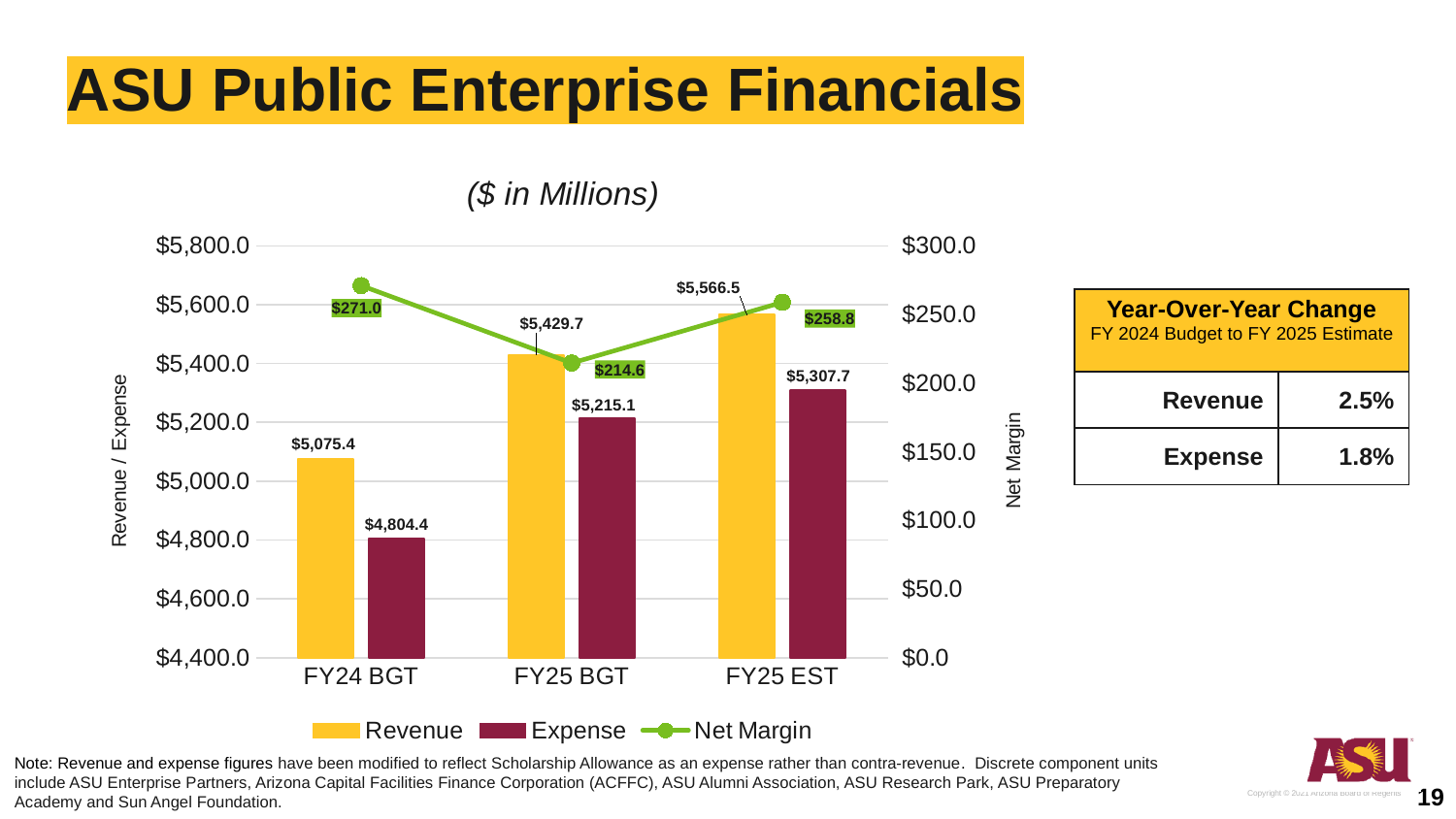
Does Expense rise or fall from FY24 BGT to FY25 EST? Rise Which category has the highest Revenue? FY25 EST What kind of chart is used to show Revenue and Expense? Bar chart What is the Net Margin value for FY25 EST? $258.8 Which category has the lowest Net Margin? FY25 BGT How many series does the legend list? 3 Which is larger, the Net Margin for FY24 BGT or for FY25 EST? FY24 BGT What is the difference between Revenue and Expense for FY24 BGT? $271.0 What is the Revenue value for FY25 BGT? $5,429.7 What is the Expense value for FY24 BGT? $4,804.4 What is the difference in Expense between FY25 EST and FY25 BGT? $92.6 How many categories are shown on the x axis? 3